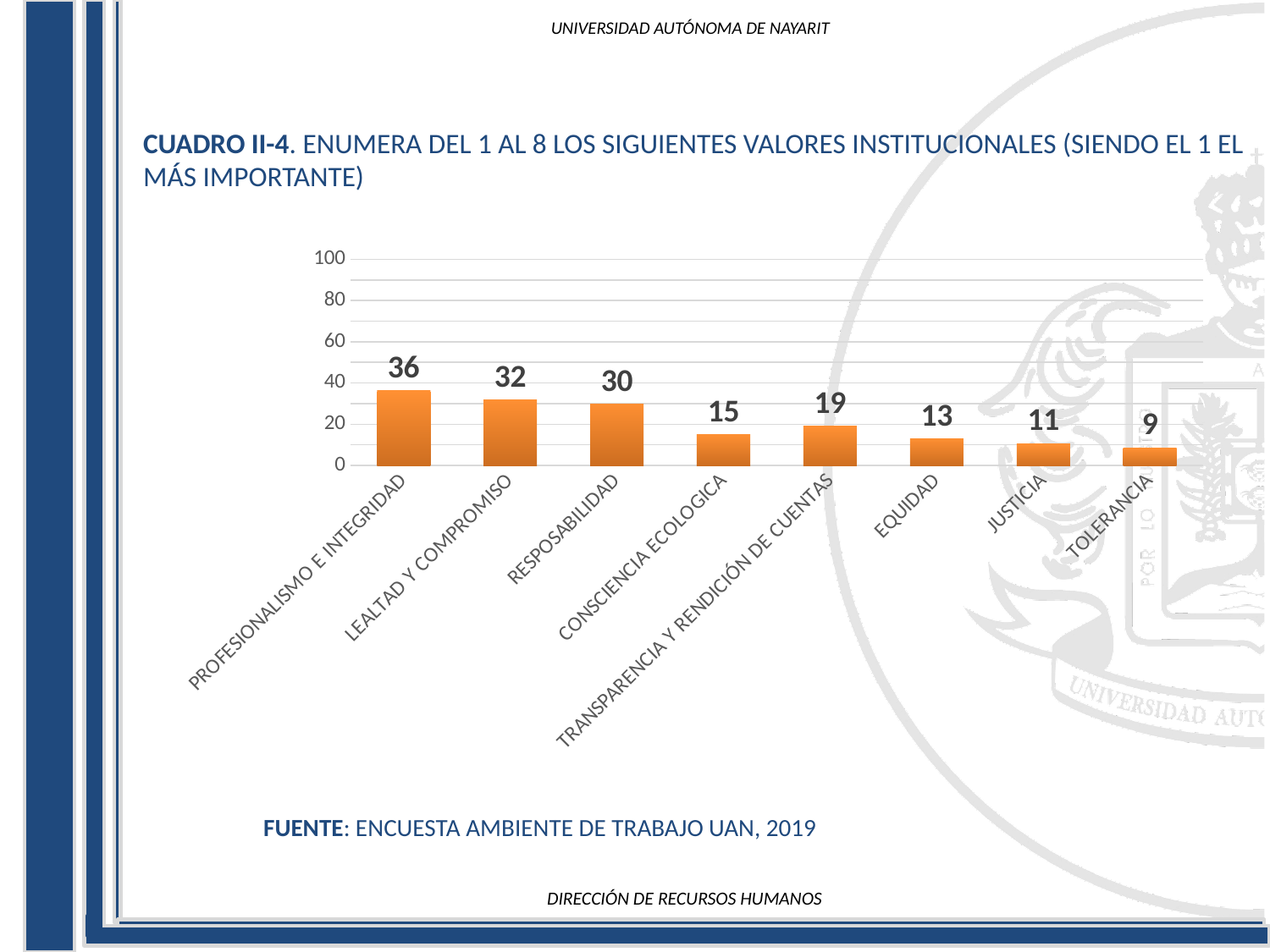
Which category has the lowest value? TOLERANCIA What kind of chart is shown on the slide? bar chart How many categories are shown in the chart? 8 What is the difference between the values for PROFESIONALISMO E INTEGRIDAD and TOLERANCIA? 27 Which category has the highest value? PROFESIONALISMO E INTEGRIDAD What is the value for TOLERANCIA? 9 What is the source cited below the chart? ENCUESTA AMBIENTE DE TRABAJO UAN, 2019 What is the value for TRANSPARENCIA Y RENDICIÓN DE CUENTAS? 19 Is the value for JUSTICIA greater or less than 20? less Which is larger, the value for CONSCIENCIA ECOLOGICA or the value for EQUIDAD? CONSCIENCIA ECOLOGICA What is the value for PROFESIONALISMO E INTEGRIDAD? 36 What is the difference between the values for LEALTAD Y COMPROMISO and RESPOSABILIDAD? 2